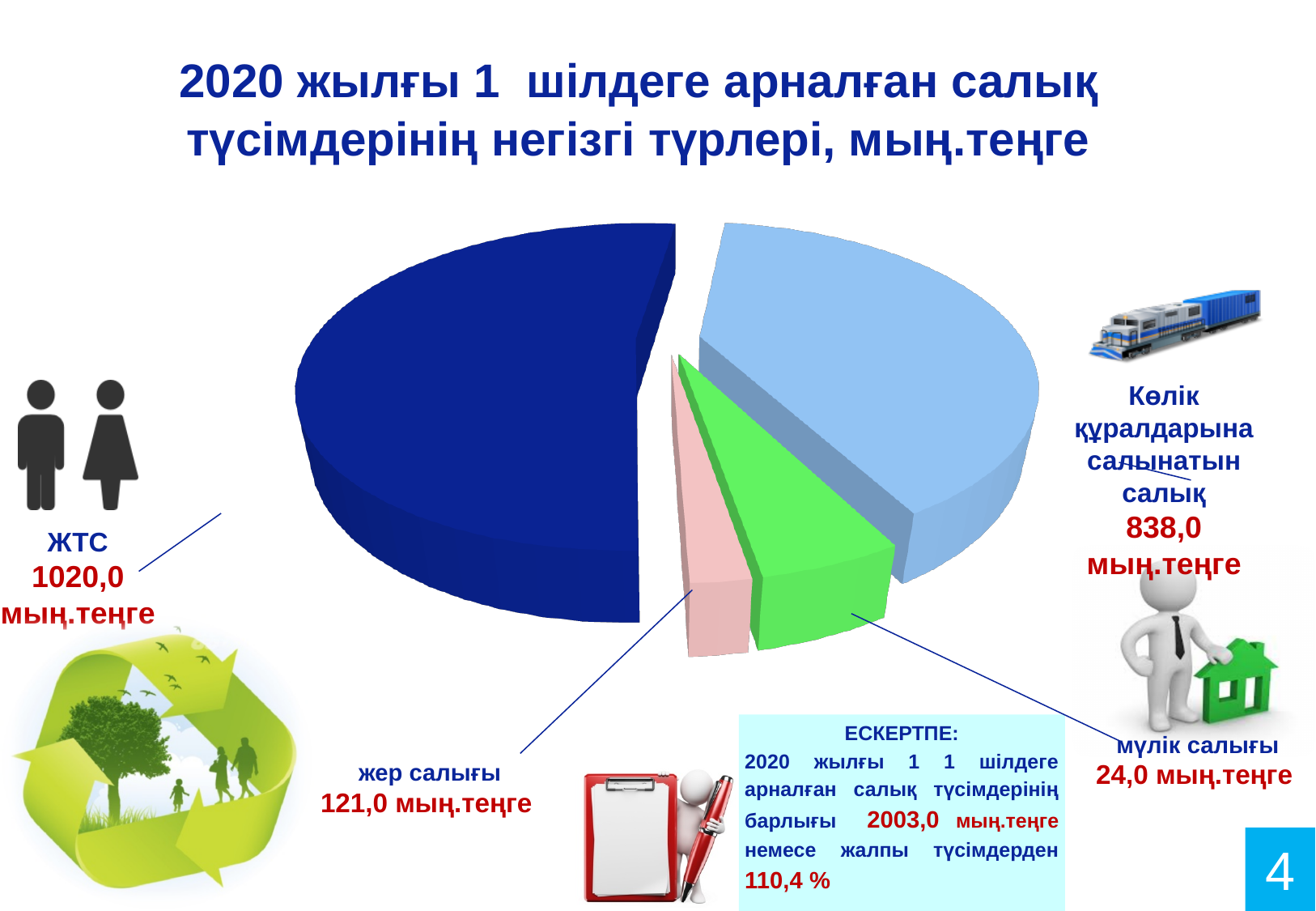
What is the value for ЖТС on the pie chart? 1020,0 мың.теңге What is the value for жер салығы on the pie chart? 121,0 мың.теңге How many slices does the pie chart have? 4 What is the difference between the values for жер салығы and мүлік салығы? 97,0 мың.теңге What is the total of all tax receipts shown on the slide? 2003,0 мың.теңге Which is larger, the value for жер салығы or the value for мүлік салығы? жер салығы Which tax type has the lowest value on the pie chart? мүлік салығы What is the value for Көлік құралдарына салынатын салық on the pie chart? 838,0 мың.теңге What is the value for мүлік салығы on the pie chart? 24,0 мың.теңге What kind of chart is shown on the slide? pie chart What is the difference between the values for ЖТС and Көлік құралдарына салынатын салық? 182,0 мың.теңге Which tax type has the highest value on the pie chart? ЖТС